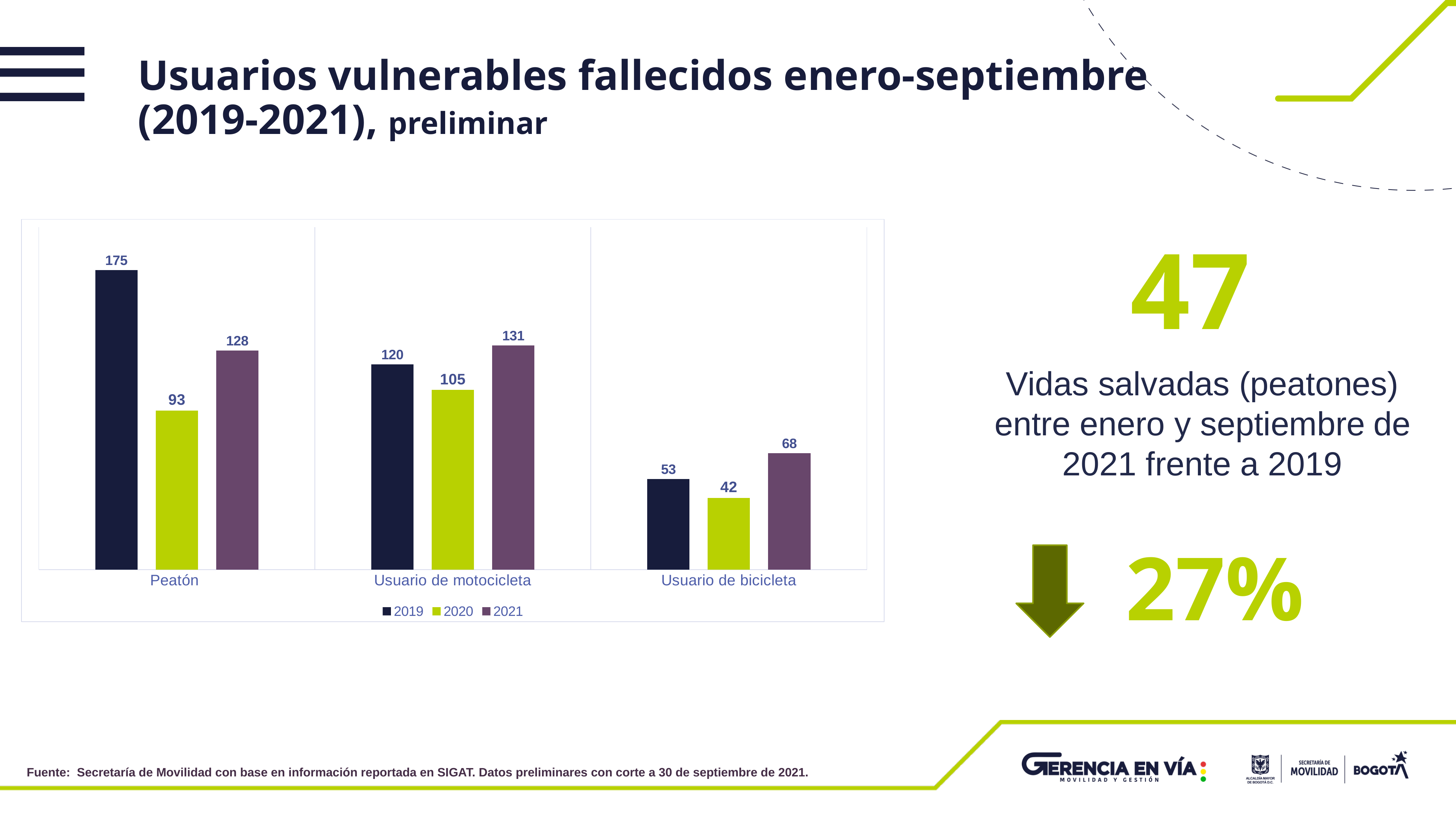
What is the total of the three years' values for Usuario de bicicleta? 163 How many series does the legend list? 3 Which series is shown in green in the legend? 2020 Which category has the highest value in 2019? Peatón What is the value for Usuario de bicicleta in 2020? 42 What is the difference between the 2019 and 2021 values for Peatón? 47 Which is larger for Usuario de motocicleta: the 2019 value or the 2021 value? 2021 What is the value for Peatón in 2019? 175 How many categories are shown on the x axis? 3 Which category has the lowest value in 2021? Usuario de bicicleta What kind of chart is shown on the slide? Bar chart What is the value for Usuario de motocicleta in 2021? 131